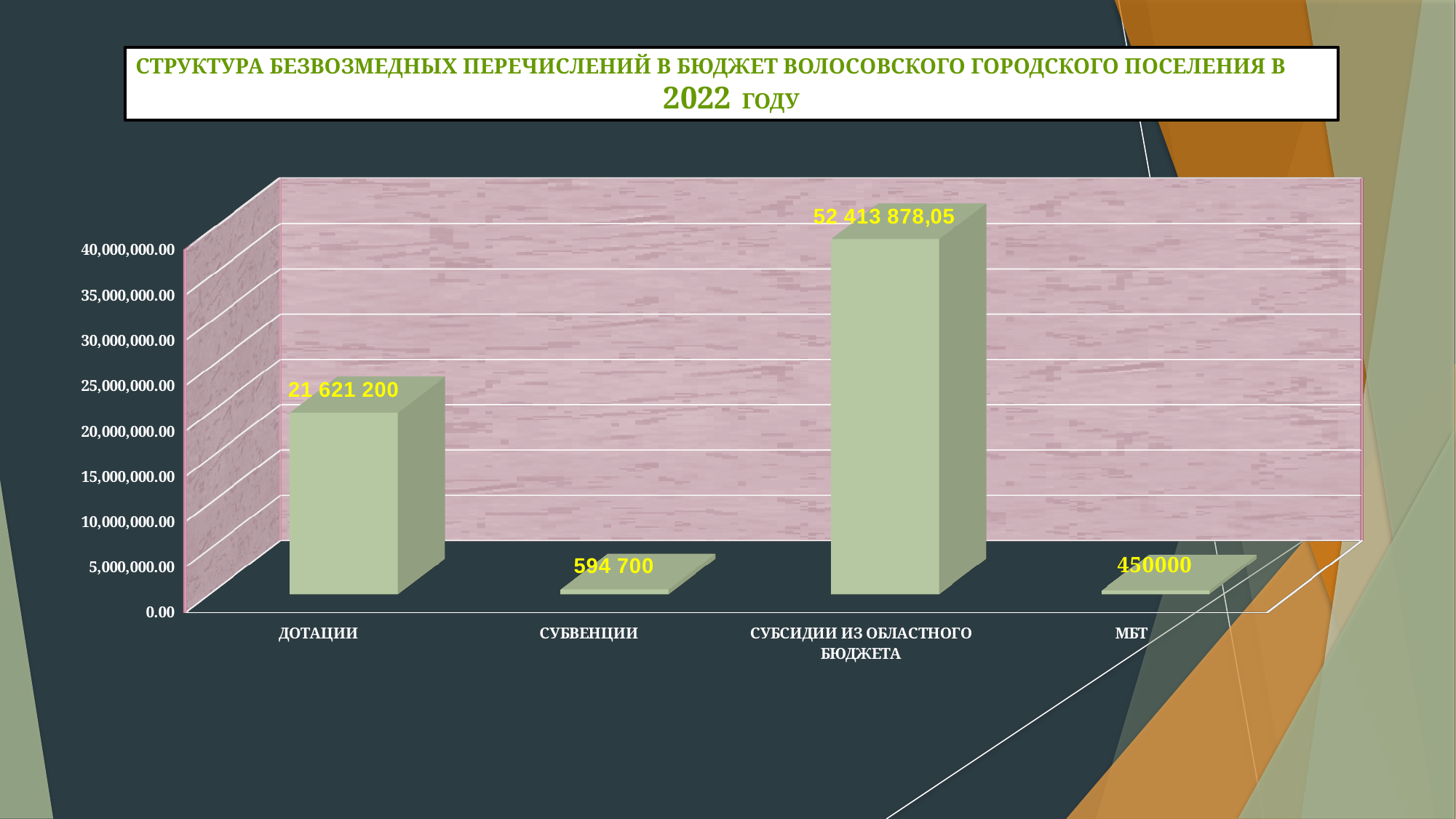
Which category has the lowest value? МБТ What is the value for ДОТАЦИИ? 21 621 200 What kind of chart is shown on the slide? bar chart What is the difference between the values for СУБВЕНЦИИ and МБТ? 144 700 Which category has the highest value? СУБСИДИИ ИЗ ОБЛАСТНОГО БЮДЖЕТА Is the value for ДОТАЦИИ greater or less than 20,000,000.00? greater What is the value for МБТ? 450000 How many categories are shown on the x axis? 4 What is the value for СУБСИДИИ ИЗ ОБЛАСТНОГО БЮДЖЕТА? 52 413 878,05 Which is larger, the value for ДОТАЦИИ or the value for СУБСИДИИ ИЗ ОБЛАСТНОГО БЮДЖЕТА? СУБСИДИИ ИЗ ОБЛАСТНОГО БЮДЖЕТА What is the value for СУБВЕНЦИИ? 594 700 What is the difference between the values for ДОТАЦИИ and СУБВЕНЦИИ? 21 026 500